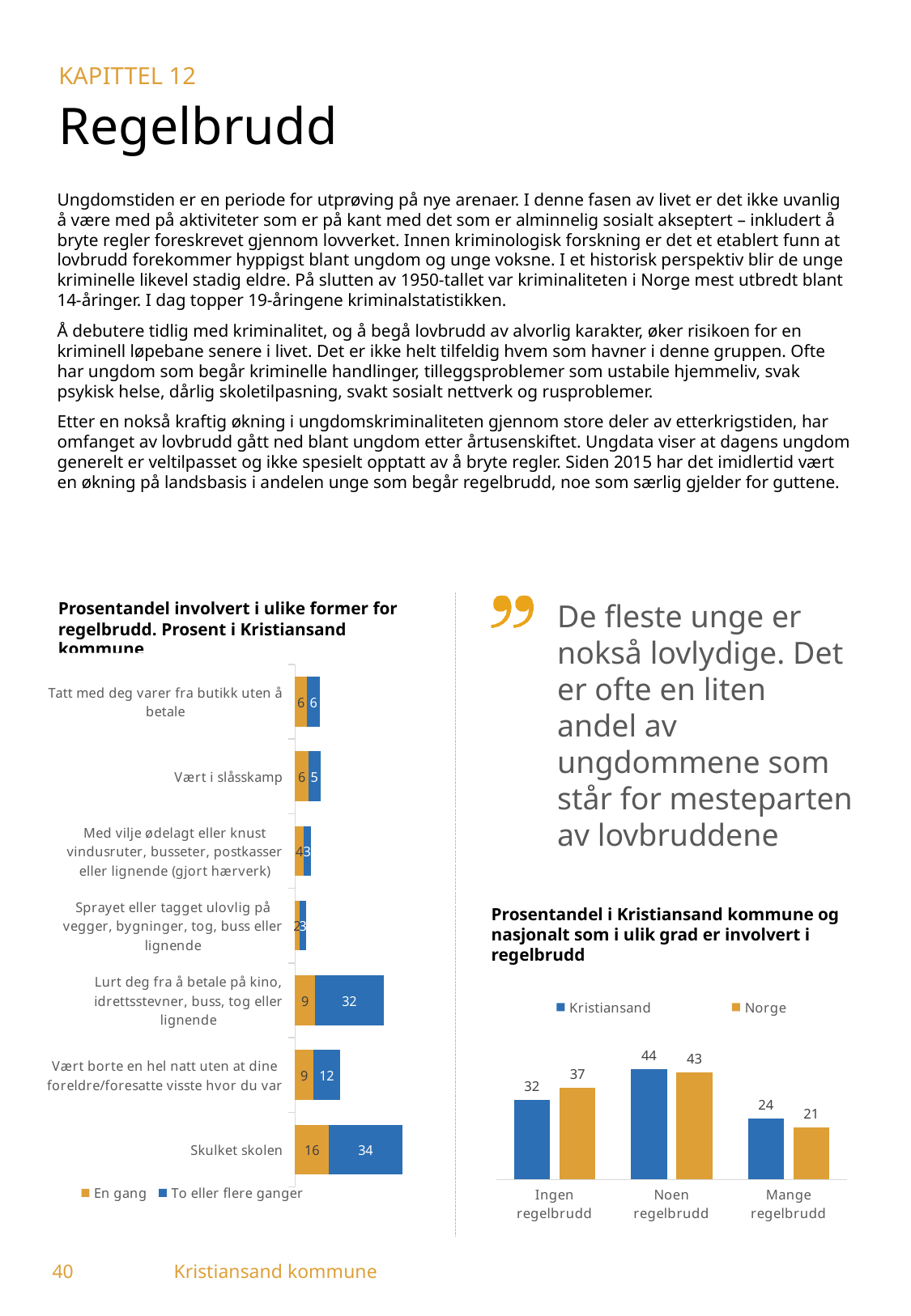
In the chart 'Prosentandel involvert i ulike former for regelbrudd', what kind of chart is it? Stacked bar chart In the chart 'Prosentandel involvert i ulike former for regelbrudd', what is the value of 'En gang' for 'Lurt deg fra å betale på kino, idrettsstevner, buss, tog eller lignende'? 9 In the chart 'Prosentandel involvert i ulike former for regelbrudd', which colour represents the series 'En gang'? Orange In the chart 'Prosentandel i Kristiansand kommune og nasjonalt som i ulik grad er involvert i regelbrudd', what is the value for Norge in the 'Mange regelbrudd' category? 21 In the chart 'Prosentandel i Kristiansand kommune og nasjonalt som i ulik grad er involvert i regelbrudd', what is the difference between Norge and Kristiansand in the 'Ingen regelbrudd' category? 5 In the chart 'Prosentandel involvert i ulike former for regelbrudd', how many categories are shown? 7 In the chart 'Prosentandel i Kristiansand kommune og nasjonalt som i ulik grad er involvert i regelbrudd', which category has the highest value for Kristiansand? Noen regelbrudd In the chart 'Prosentandel i Kristiansand kommune og nasjonalt som i ulik grad er involvert i regelbrudd', how many series does the legend list? 2 In the chart 'Prosentandel i Kristiansand kommune og nasjonalt som i ulik grad er involvert i regelbrudd', which is larger in the 'Mange regelbrudd' category, Kristiansand or Norge? Kristiansand In the chart 'Prosentandel involvert i ulike former for regelbrudd', what is the total of the stacked bar for 'Skulket skolen'? 50 In the chart 'Prosentandel involvert i ulike former for regelbrudd', what is the value of 'To eller flere ganger' for 'Skulket skolen'? 34 In the chart 'Prosentandel i Kristiansand kommune og nasjonalt som i ulik grad er involvert i regelbrudd', what is the value for Kristiansand in the 'Ingen regelbrudd' category? 32